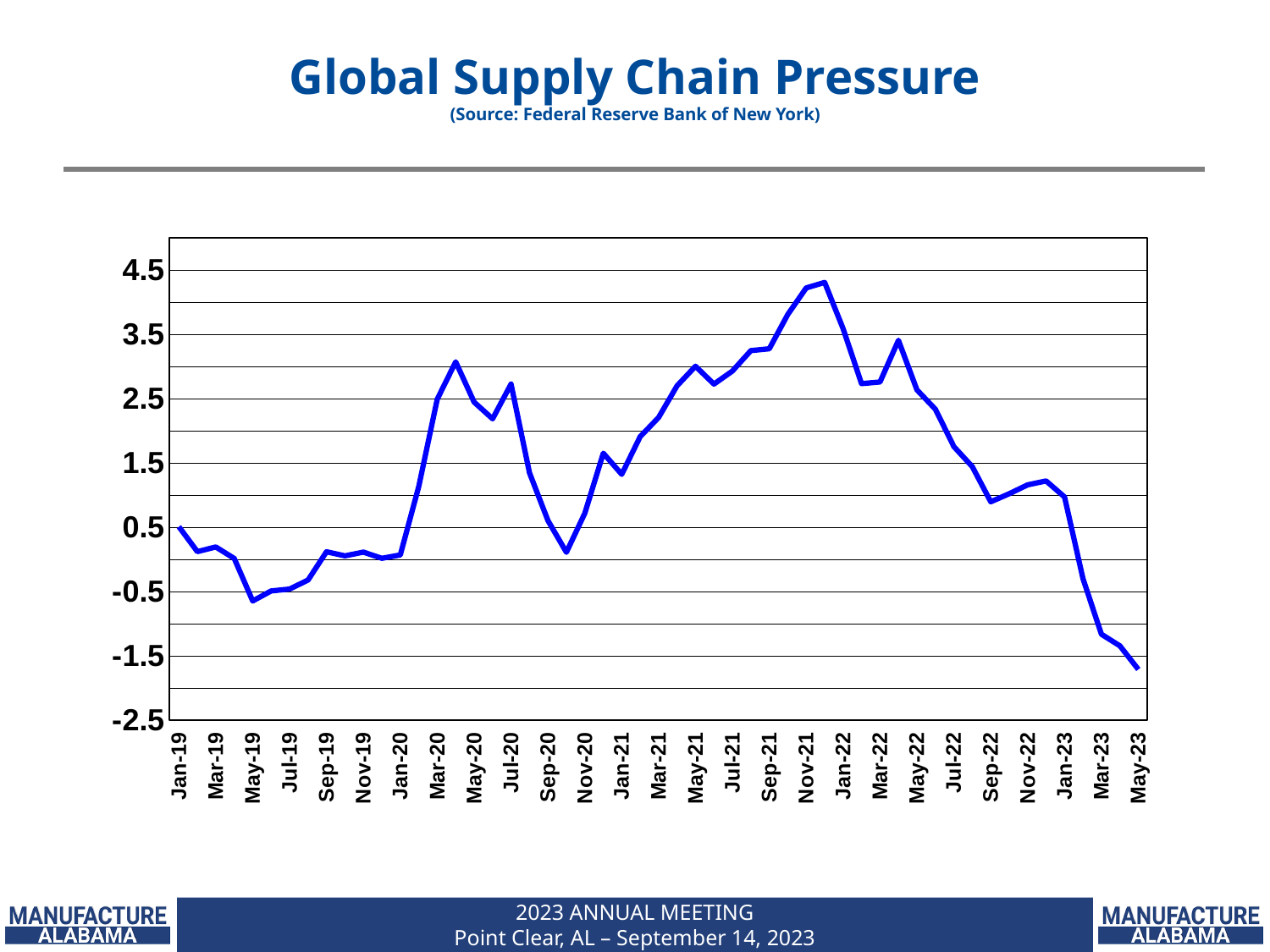
Is the value for May-19 greater or less than -0.5? less Does the line rise or fall between Jan-22 and May-23? fall Which is larger, the value for Jan-22 or the value for Jan-23? Jan-22 Is the value for Mar-23 greater or less than -0.5? less What is the title of the chart? Global Supply Chain Pressure Is the value for May-23 greater or less than -1.5? less What source is cited for the chart data? Federal Reserve Bank of New York How many month labels are shown along the x axis? 27 What kind of chart is shown on the slide? line chart Which x-axis label has the lowest value on the line? May-23